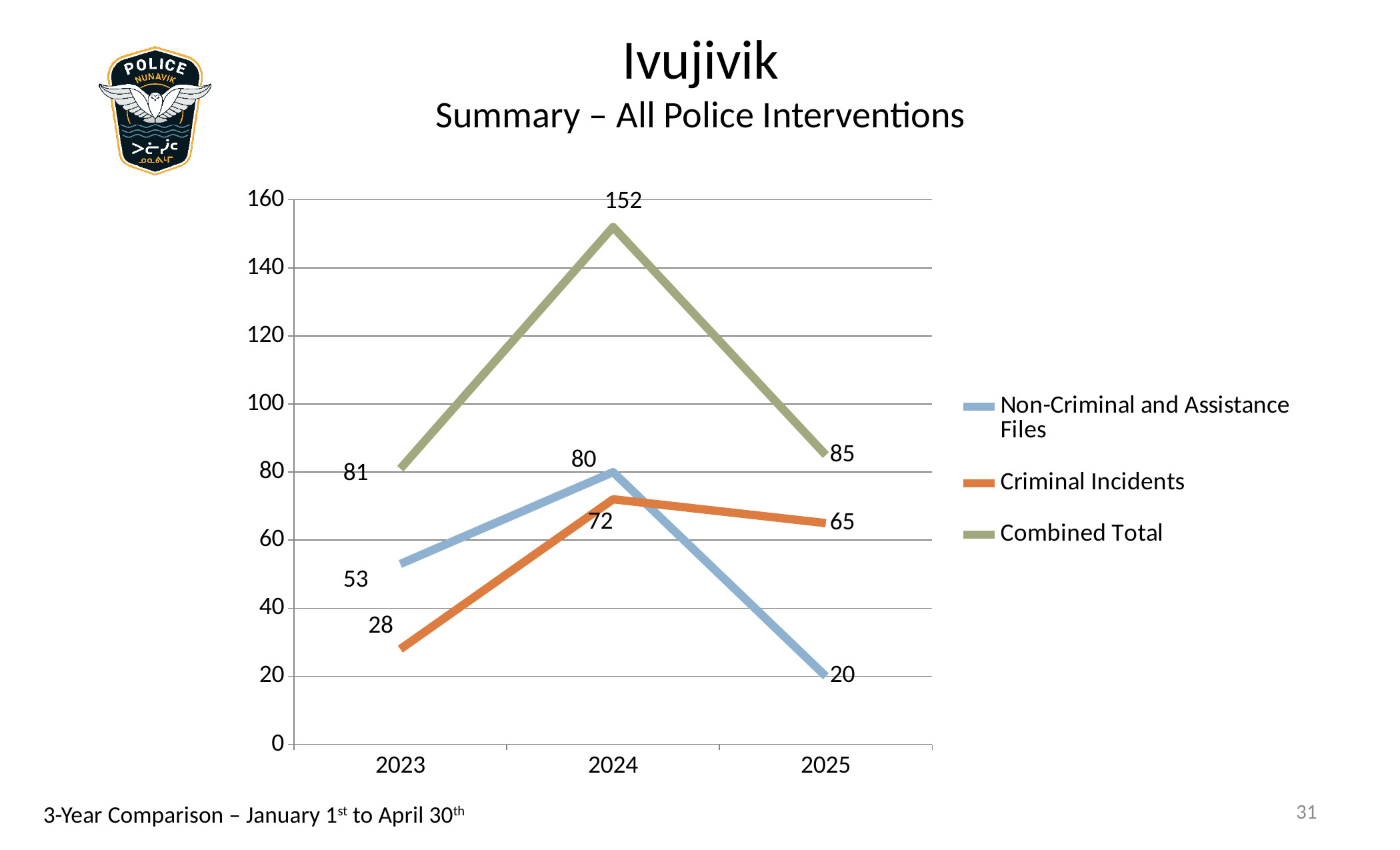
Which is larger in 2025: Criminal Incidents or Non-Criminal and Assistance Files? Criminal Incidents What is the difference between the Combined Total in 2024 and in 2025? 67 In which year is the Non-Criminal and Assistance Files value lowest? 2025 How many series does the legend list? 3 Is the Combined Total for 2023 greater or less than 100? less What is the value for Criminal Incidents in 2023? 28 Does the Criminal Incidents series rise or fall from 2023 to 2024? rise What kind of chart is shown on the slide? line chart What is the value for Non-Criminal and Assistance Files in 2025? 20 How many years are shown on the x axis? 3 What is the Combined Total value for 2024? 152 In which year is the Combined Total highest? 2024